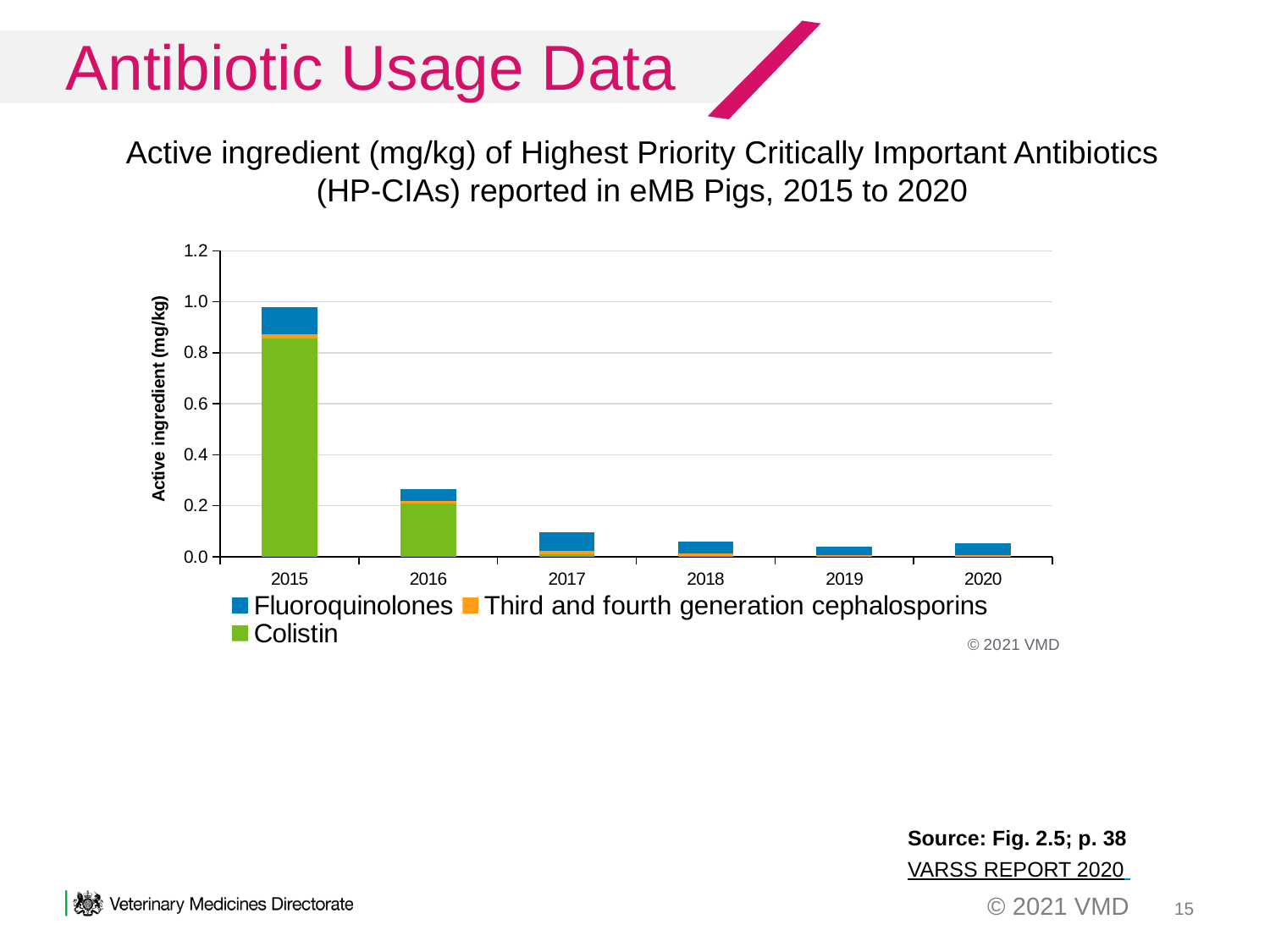
Which year has the highest total active ingredient (mg/kg) in the chart? 2015 Which year has the larger total active ingredient, 2015 or 2016? 2015 Which series is shown in green in the chart's legend? Colistin How many series does the chart's legend list? 3 Is the Colistin value for 2015 greater or less than 0.6 mg/kg? greater Do the total values rise or fall from 2015 to 2020 in the chart? Fall What is the label on the y axis of the chart? Active ingredient (mg/kg) Is the total value for 2017 greater or less than 0.2 mg/kg? less What kind of chart is shown on the slide? Stacked bar chart Is the total value for 2016 greater or less than 0.4 mg/kg? less How many years are shown along the x axis of the chart? 6